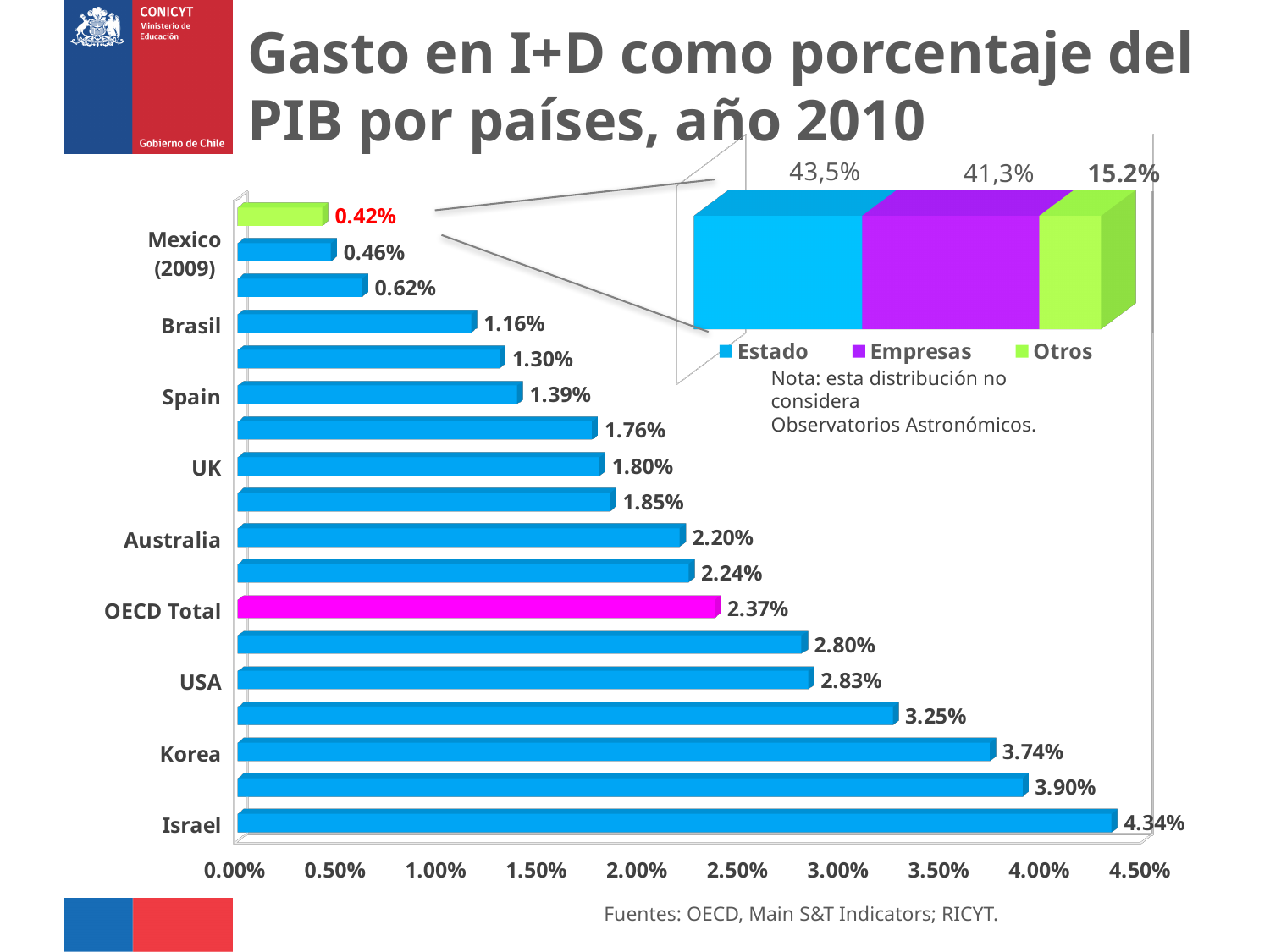
What kind of chart is the main chart on the slide? Bar chart In the main bar chart, what is the value for Brasil? 1.16% How many series does the legend of the inset stacked bar chart list? 3 In the main bar chart, what is the smallest value shown on any bar? 0.42% In the main bar chart, what is the value for Israel? 4.34% In the main bar chart, what is the value for Korea? 3.74% In the main bar chart, what is the difference between the values for Israel and Korea? 0.60% In the main bar chart, what is the value for OECD Total? 2.37% In the inset stacked bar chart at the top right, what is the value for Estado? 43,5% In the main bar chart, which labelled country has the highest value? Israel In the main bar chart, which is larger, the value for USA or the value for Australia? USA How many bars are plotted in the main bar chart? 18